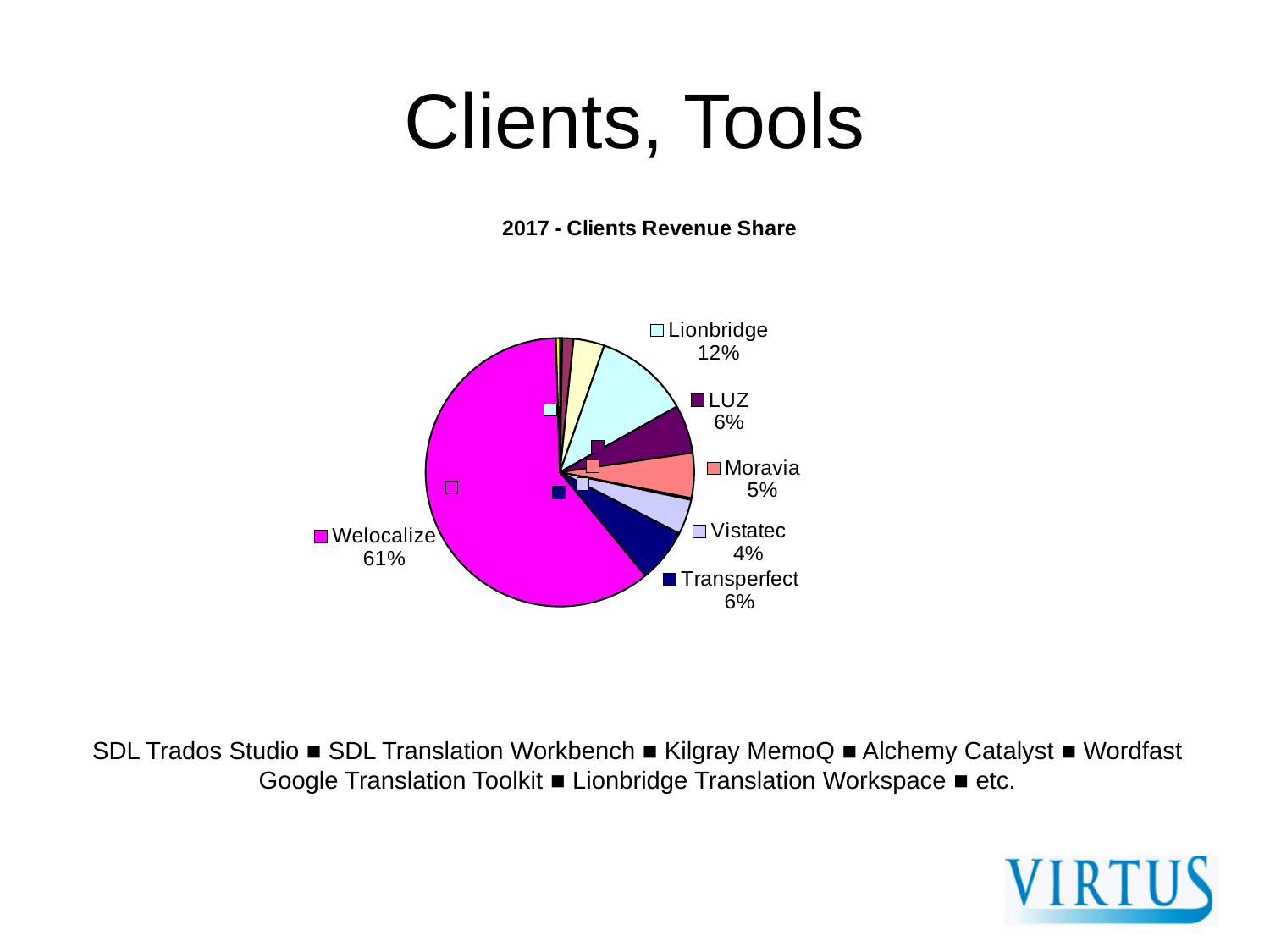
Which client has the largest revenue share? Welocalize What share of revenue does Welocalize account for? 61% What is the revenue share for Transperfect? 6% What is the title of the chart? 2017 - Clients Revenue Share What is the revenue share for Moravia? 5% What is the difference in revenue share between Transperfect and Vistatec? 2 percentage points What is the revenue share for Lionbridge? 12% What type of chart is shown on the slide? Pie chart Which has a larger revenue share, Moravia or Vistatec? Moravia By how many percentage points does Welocalize's share exceed Lionbridge's share? 49 percentage points Which has a larger revenue share, Lionbridge or LUZ? Lionbridge What is the revenue share for Vistatec? 4%